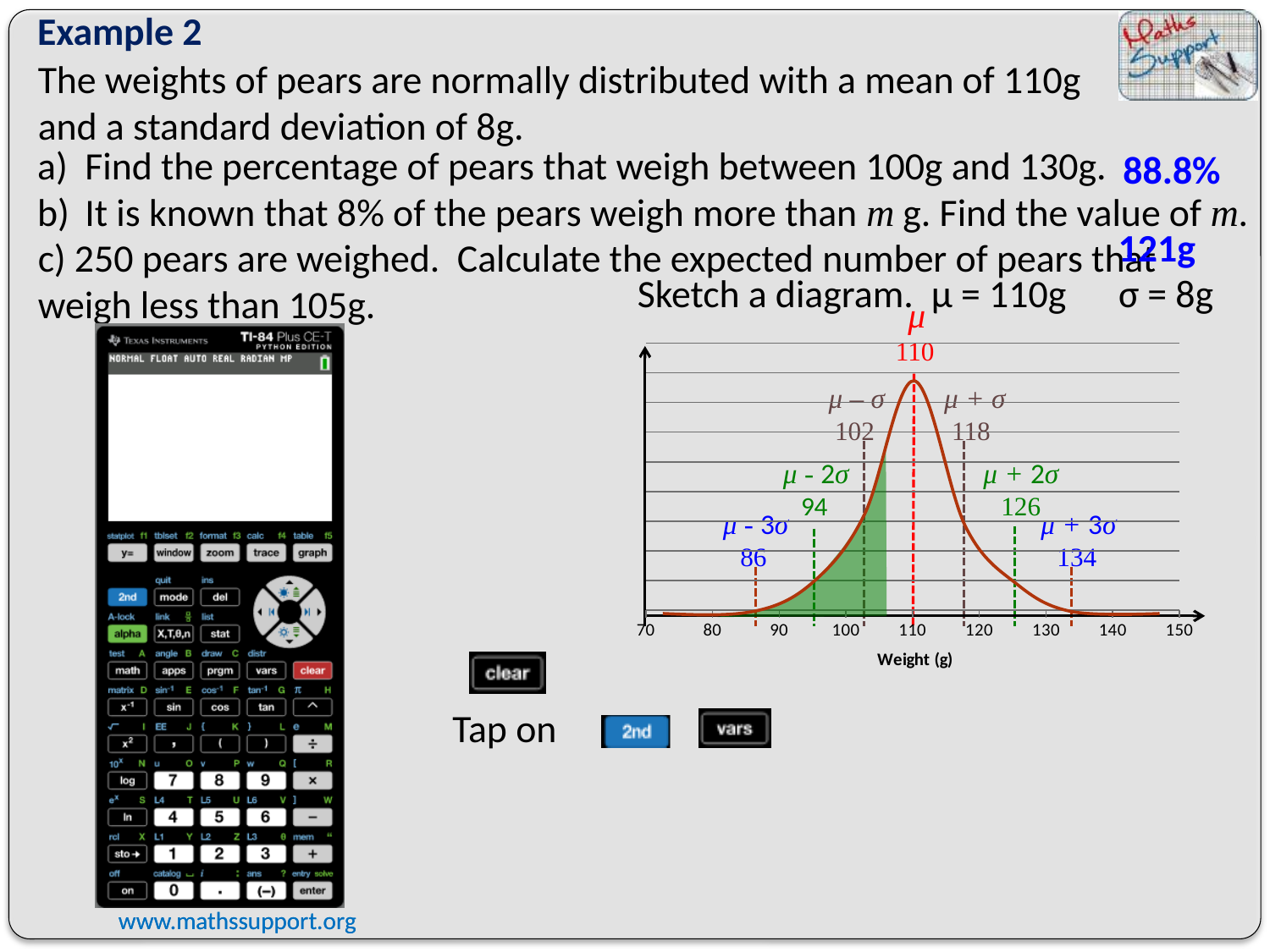
What is the difference between the values labelled at μ + σ and μ − σ on the chart? 16 What kind of chart is shown on the slide? line chart What weight value is labelled at μ + σ on the chart? 118 What weight value is labelled at μ − 3σ on the chart? 86 What is the highest value shown on the horizontal axis of the chart? 150 What is the title of the horizontal axis on the chart? Weight (g) What weight value is labelled at μ + 2σ on the chart? 126 What weight value is labelled at μ + 3σ on the chart? 134 How many labelled weight values (μ and the σ markers) are marked on the chart? 7 What weight value is labelled at μ − σ on the chart? 102 What weight value is labelled at μ on the chart? 110 What weight value is labelled at μ − 2σ on the chart? 94